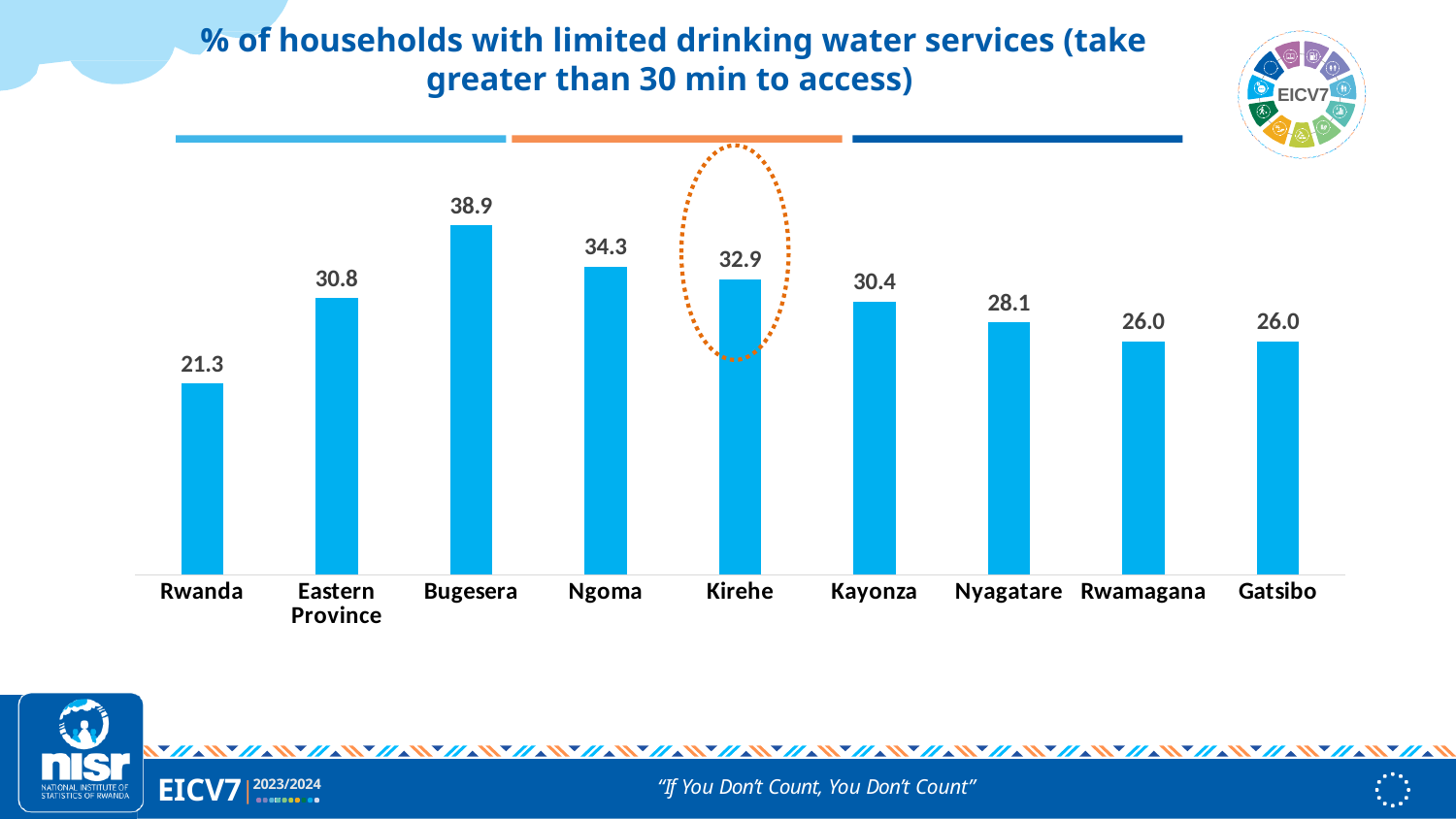
What kind of chart is shown on the slide? Bar chart Which category has the highest value? Bugesera Which category has the lowest value? Rwanda Which is larger, the value for Kayonza or the value for Nyagatare? Kayonza What is the difference between the values for Kirehe and Rwanda? 11.6 What is the value for Eastern Province? 30.8 How many categories are shown on the x axis? 9 What is the value for Rwanda? 21.3 Which category is highlighted with a dotted orange oval? Kirehe What is the difference between the values for Bugesera and Ngoma? 4.6 What is the title of the chart? % of households with limited drinking water services (take greater than 30 min to access) What is the value for Kirehe? 32.9